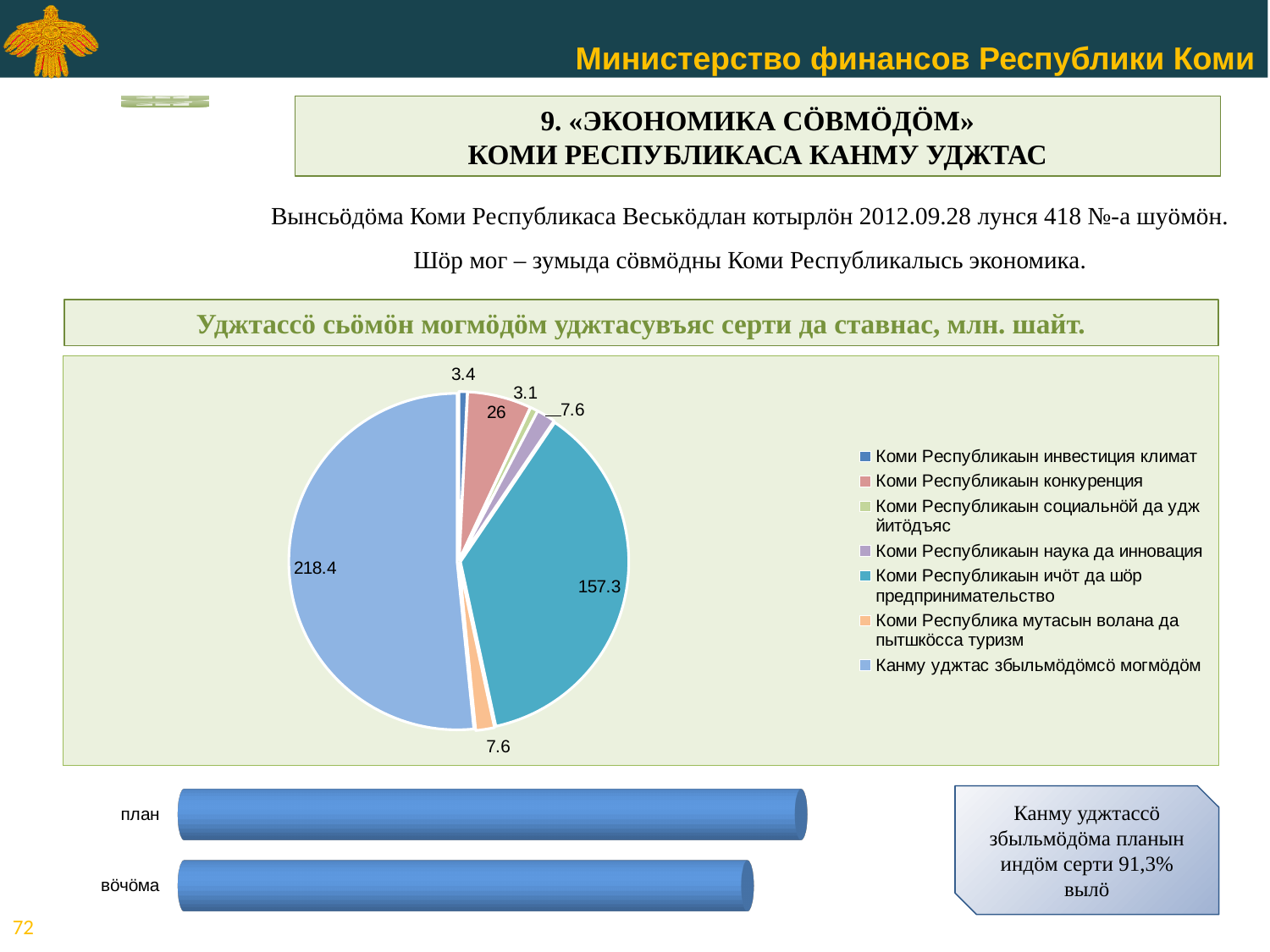
In the bar chart at the bottom of the slide, which bar is longer: план or вöчöма? план In the pie chart, which is larger: the value for Коми Республикаын конкуренция or the value for Коми Республикаын наука да инновация? Коми Республикаын конкуренция In the pie chart, what is the value for Коми Республикаын инвестиция климат? 3.4 What is the title of the pie chart? Уджтассö сьöмöн могмöдöм уджтасувъяс серти да ставнас, млн. шайт. In the pie chart, what is the difference between the values for Канму уджтас збыльмöдöмсö могмöдöм and Коми Республикаын ичöт да шöр предпринимательство? 61.1 How many categories does the pie chart's legend list? 7 In the pie chart, what is the value for Коми Республикаын конкуренция? 26 In the pie chart, what is the value for Коми Республикаын ичöт да шöр предпринимательство? 157.3 In the pie chart, which category has the smallest slice? Коми Республикаын социальнöй да удж йитöдъяс What kind of chart is the upper chart on the slide? pie chart In the pie chart, which category has the largest slice? Канму уджтас збыльмöдöмсö могмöдöм In the pie chart, what is the value for Канму уджтас збыльмöдöмсö могмöдöм? 218.4